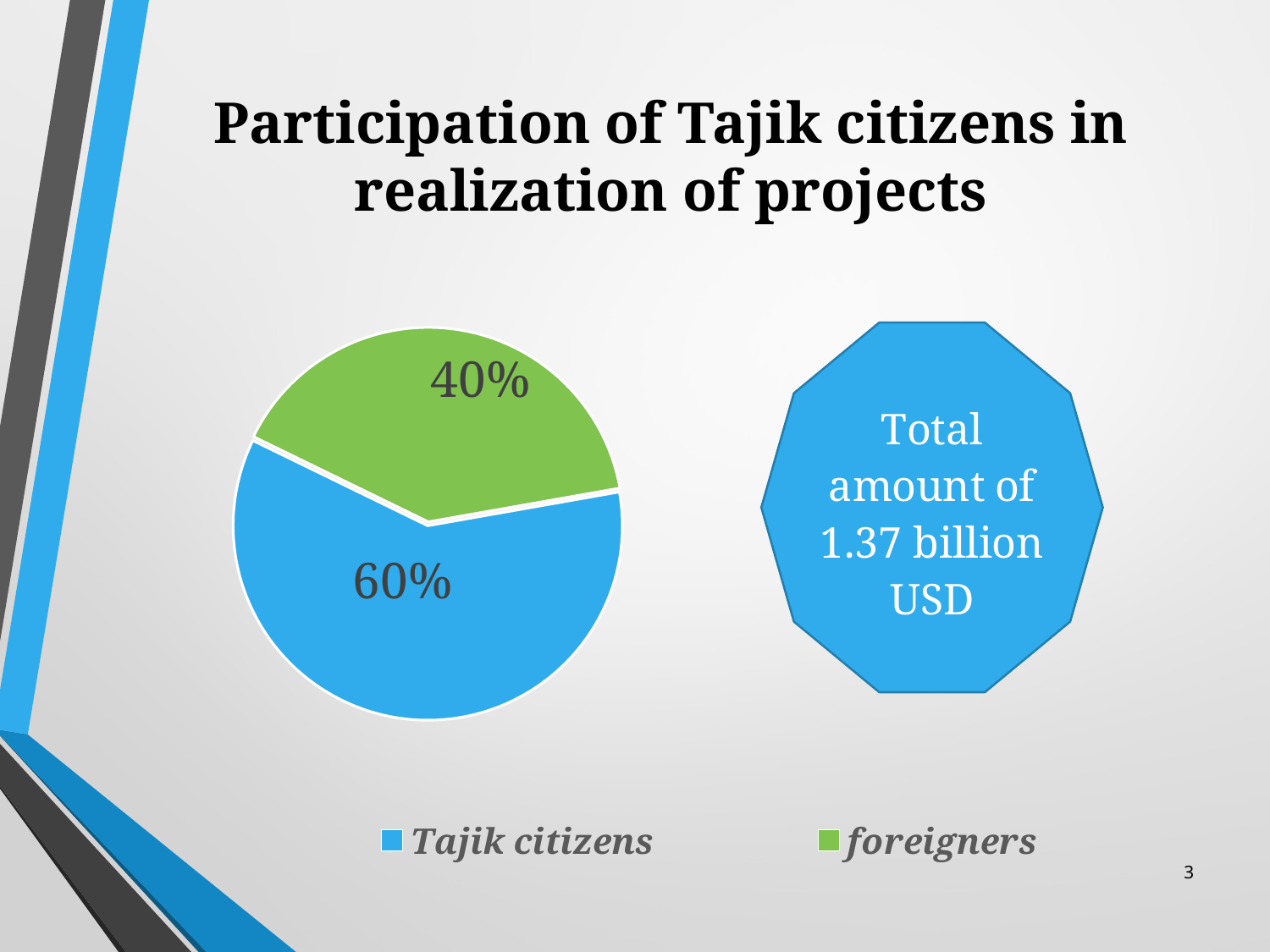
What kind of chart is shown on the slide? pie chart What colour is the slice for foreigners? green Which slice of the pie is the smallest? foreigners What colour is the slice for Tajik citizens? blue Which is larger, the share for Tajik citizens or the share for foreigners? Tajik citizens How many slices does the pie chart have? 2 What share of the pie is labelled for Tajik citizens? 60% Is the share for foreigners greater or less than 50%? less What share of the pie is labelled for foreigners? 40% How many entries does the legend list? 2 Which slice of the pie is the largest? Tajik citizens What is the difference in percentage points between the Tajik citizens slice and the foreigners slice? 20%